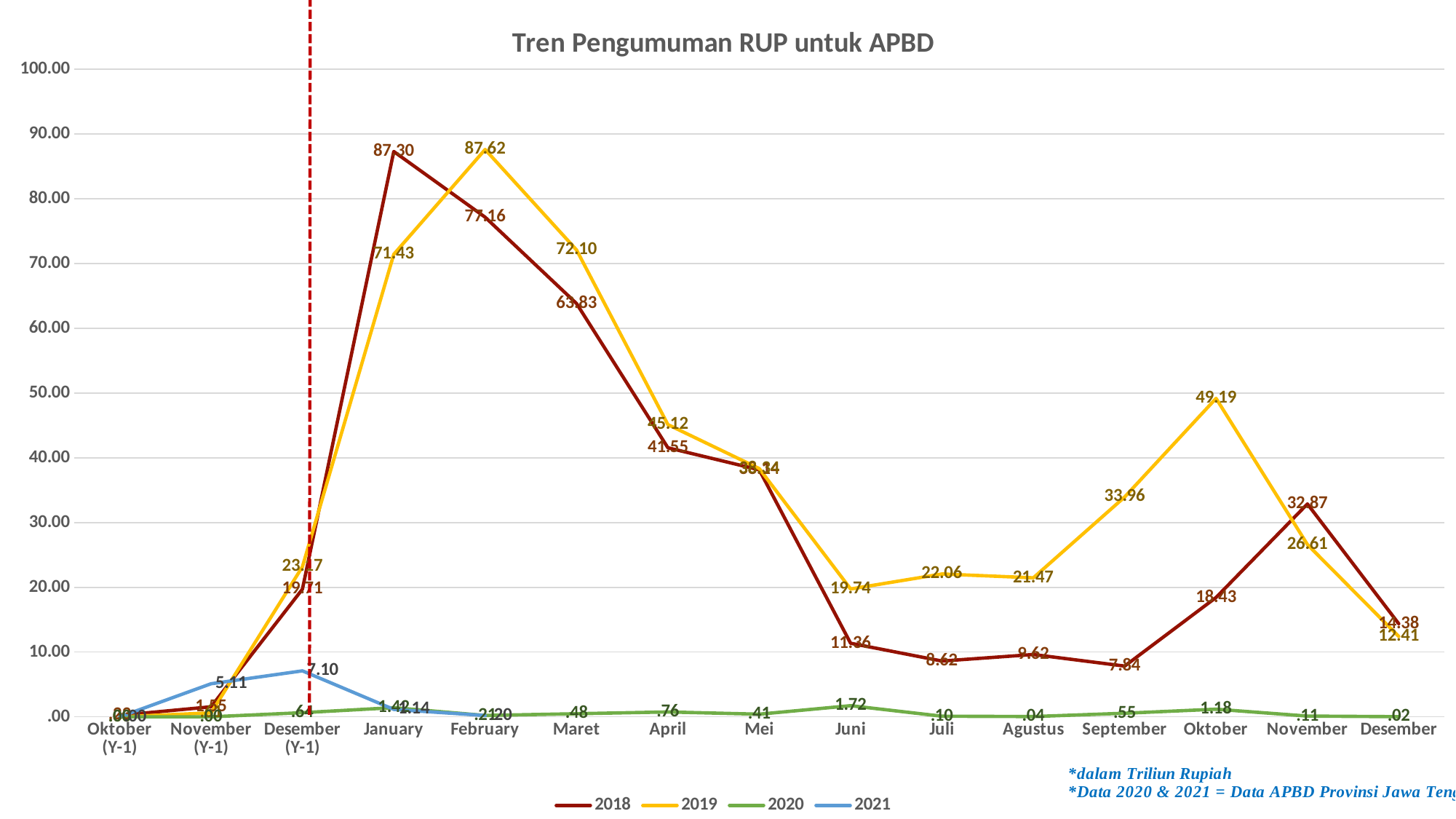
What is the value for 2019 in February? 87.62 In Maret, which series has the larger value, 2018 or 2019? 2019 How many series does the legend list? 4 What is the value for 2019 in Oktober? 49.19 How many categories are on the x axis? 15 What is the value for 2021 in Desember (Y-1)? 7.10 What is the value for 2018 in January? 87.30 Does the 2018 series rise or fall from January to Juli? fall What is the title of the chart? Tren Pengumuman RUP untuk APBD In which month does the 2019 series reach its highest value? February What is the difference between the 2019 and 2018 values in Oktober? 30.76 What kind of chart is shown on the slide? line chart